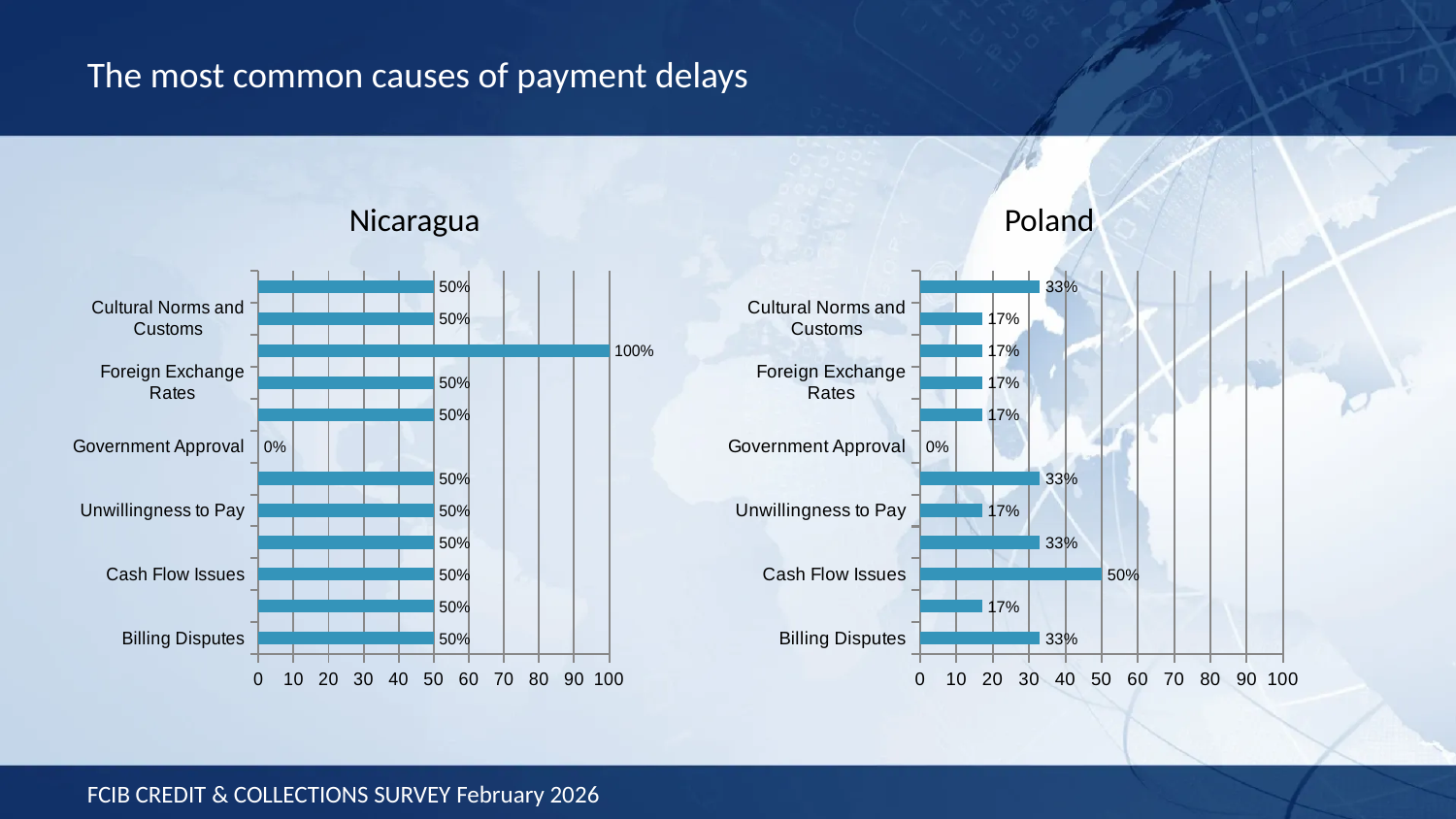
In the Poland chart, what is the value for Cash Flow Issues? 50% In the Poland chart, which labeled cause has the lowest value? Government Approval Which is larger: Billing Disputes for Nicaragua or Billing Disputes for Poland? Nicaragua What kind of chart is used for Nicaragua? Bar chart In the Poland chart, what is the value for Government Approval? 0% In the Nicaragua chart, what is the value for Billing Disputes? 50% In the Nicaragua chart, what is the highest value shown on any bar? 100% In the Poland chart, which labeled cause has the highest value? Cash Flow Issues In the Poland chart, what is the value for Billing Disputes? 33% In the Nicaragua chart, what is the value for Government Approval? 0% In the Poland chart, what is the difference between Cash Flow Issues and Billing Disputes? 17 percentage points How many bars are plotted in the Poland chart? 12